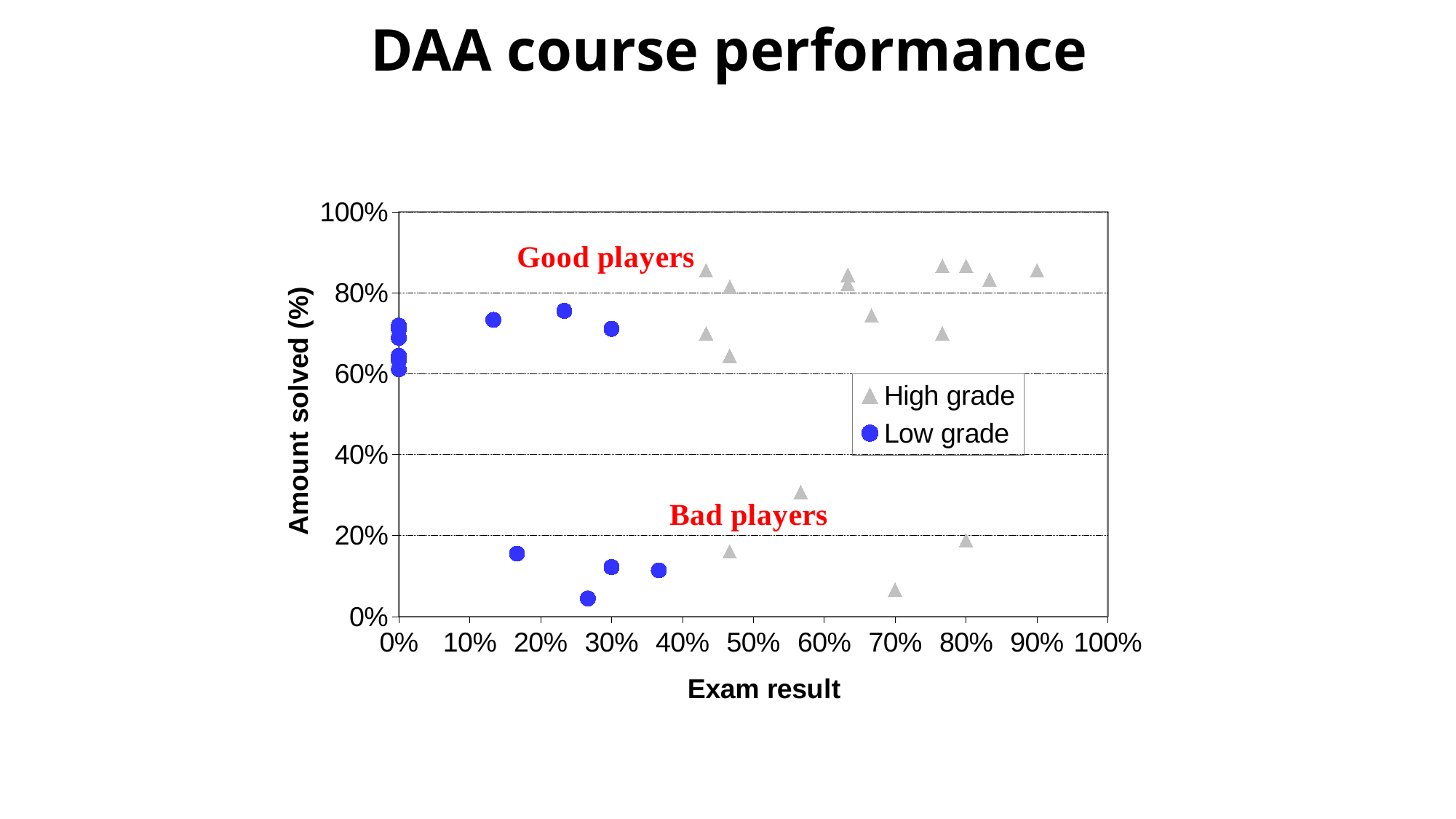
Is the amount solved for the Low grade point with the lowest amount solved greater or less than 20%? less Is the exam result for every Low grade point greater or less than 40%? less Is the amount solved for the High grade point with the highest exam result greater or less than 80%? greater What kind of chart is shown on the slide? scatter chart How many series does the legend list? 2 What is the title of the chart? DAA course performance Which two series are listed in the legend? High grade, Low grade